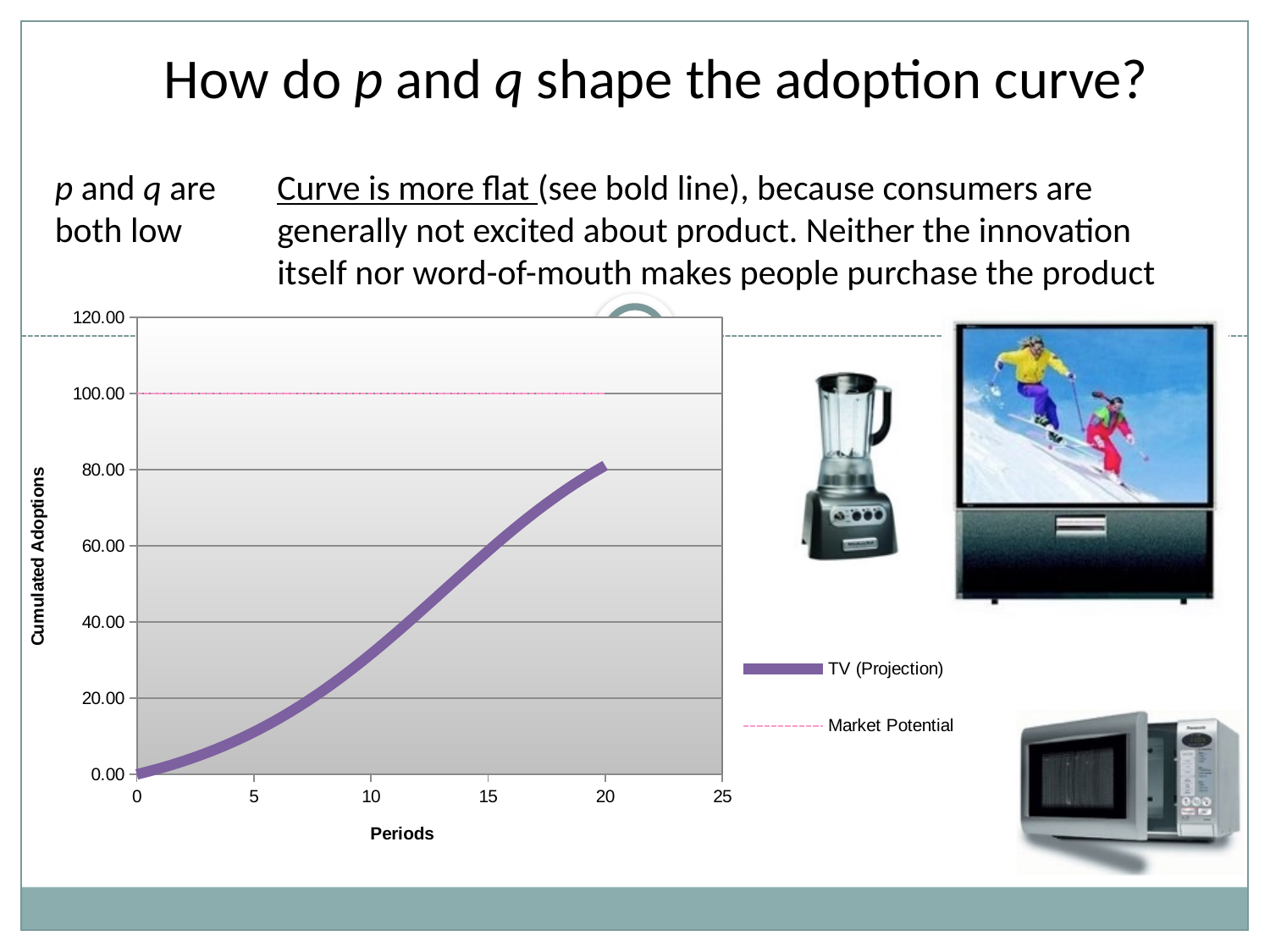
What are the two series named in the chart legend? TV (Projection) and Market Potential At period 20, which is higher: the TV (Projection) line or the Market Potential line? Market Potential What is the title of the chart's vertical axis? Cumulated Adoptions What kind of chart is shown on the slide? line chart Is the TV (Projection) value at period 5 greater or less than 20? less Is the TV (Projection) value at period 10 greater or less than 40? less Is the TV (Projection) value at period 20 greater or less than 100? less What is the highest tick value shown on the vertical axis of the chart? 120.00 Does the TV (Projection) line rise or fall as Periods increase? rise At what value does the Market Potential line sit on the vertical axis? 100.00 How many series does the chart legend list? 2